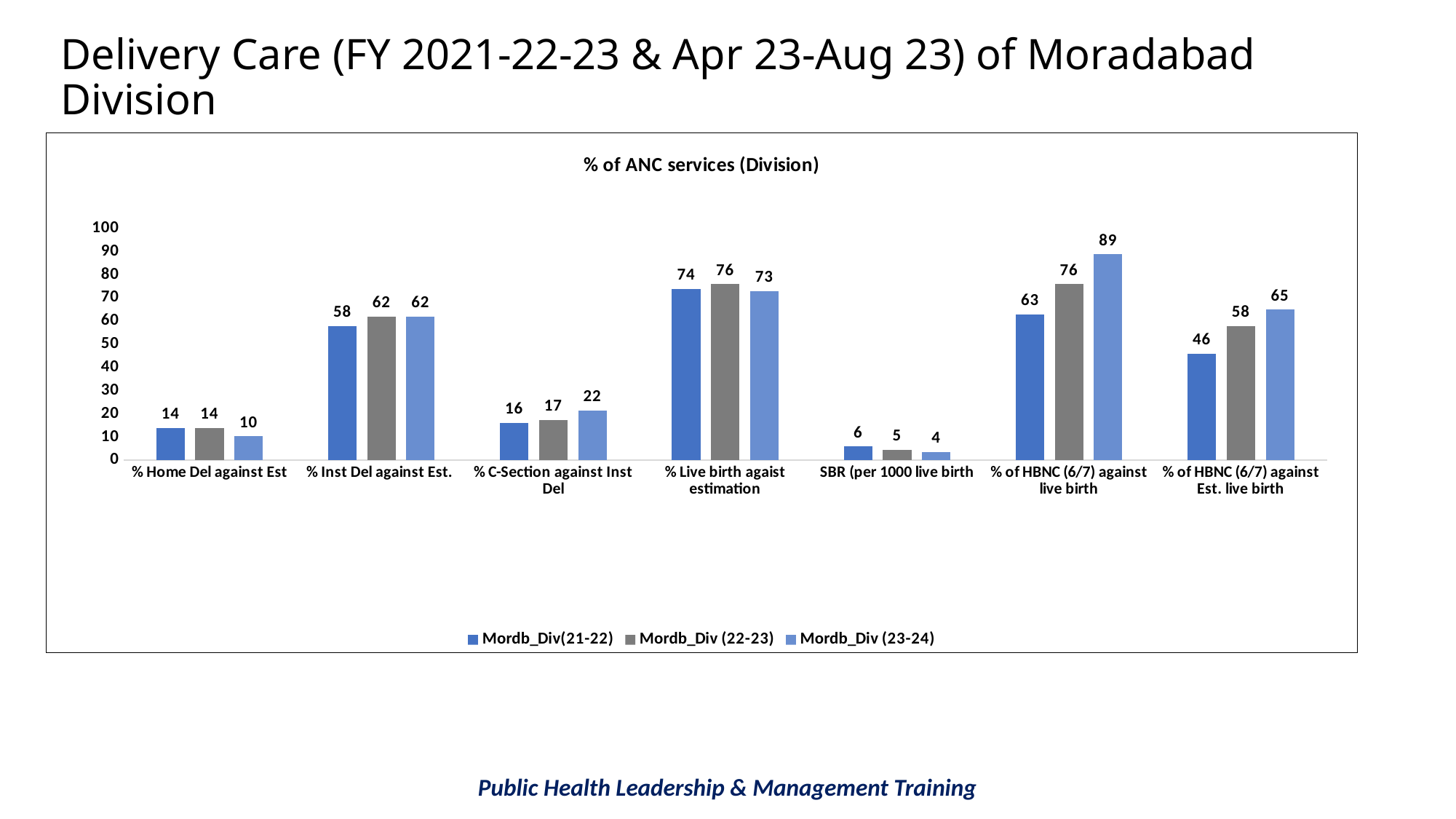
How many series does the legend list? 3 Is the value for Mordb_Div (22-23) in the '% Live birth against estimation' category greater or less than 70? greater What is the value for Mordb_Div(21-22) in the '% Inst Del against Est.' category? 58 What is the difference between the Mordb_Div (23-24) and Mordb_Div(21-22) values in the '% of HBNC (6/7) against Est. live birth' category? 19 Which category has the lowest value for the Mordb_Div(21-22) series? SBR (per 1000 live birth What kind of chart is shown on the slide? bar chart What is the title of the chart? % of ANC services (Division) Which category has the highest value for the Mordb_Div (23-24) series? % of HBNC (6/7) against live birth What is the value for Mordb_Div (22-23) in the 'SBR (per 1000 live birth' category? 5 How many categories are shown on the x axis of the chart? 7 In the '% C-Section against Inst Del' category, which series has the larger value: Mordb_Div(21-22) or Mordb_Div (23-24)? Mordb_Div (23-24) What is the value for Mordb_Div (23-24) in the '% of HBNC (6/7) against live birth' category? 89